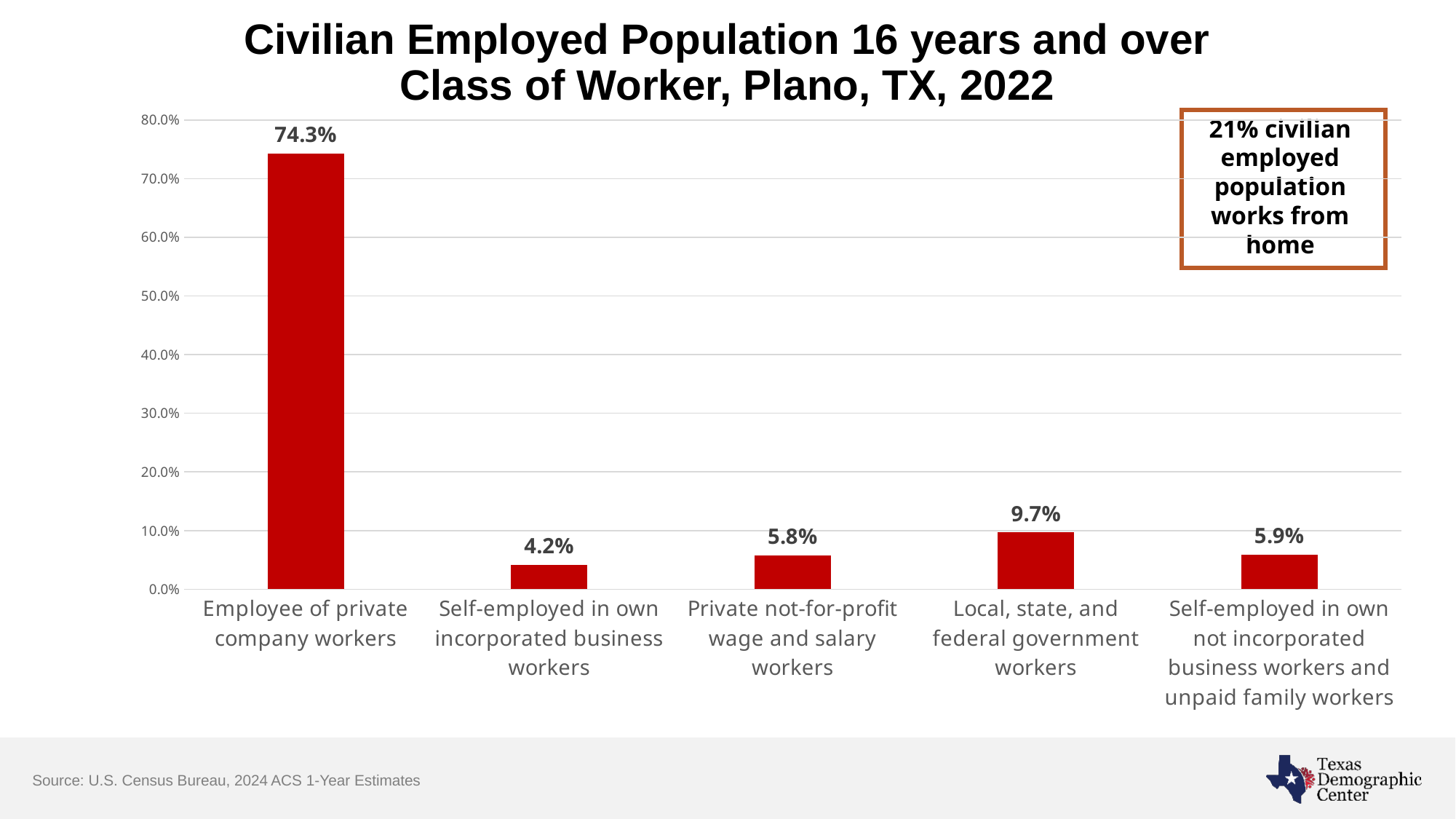
Which class of worker has the highest share? Employee of private company workers What is the value for local, state, and federal government workers? 9.7% What kind of chart is shown on the slide? Bar chart Is the value for local, state, and federal government workers greater or less than 10.0%? less What is the difference between the value for employees of private company workers and the value for local, state, and federal government workers? 64.6% According to the text box on the slide, what percentage of the civilian employed population works from home? 21% What percentage of the civilian employed population are employees of private company workers? 74.3% Which is larger: the value for private not-for-profit wage and salary workers or the value for self-employed in own not incorporated business workers and unpaid family workers? Self-employed in own not incorporated business workers and unpaid family workers What is the value for self-employed in own incorporated business workers? 4.2% What is the value for private not-for-profit wage and salary workers? 5.8% How many classes of worker are shown on the chart? 5 Which class of worker has the lowest share? Self-employed in own incorporated business workers